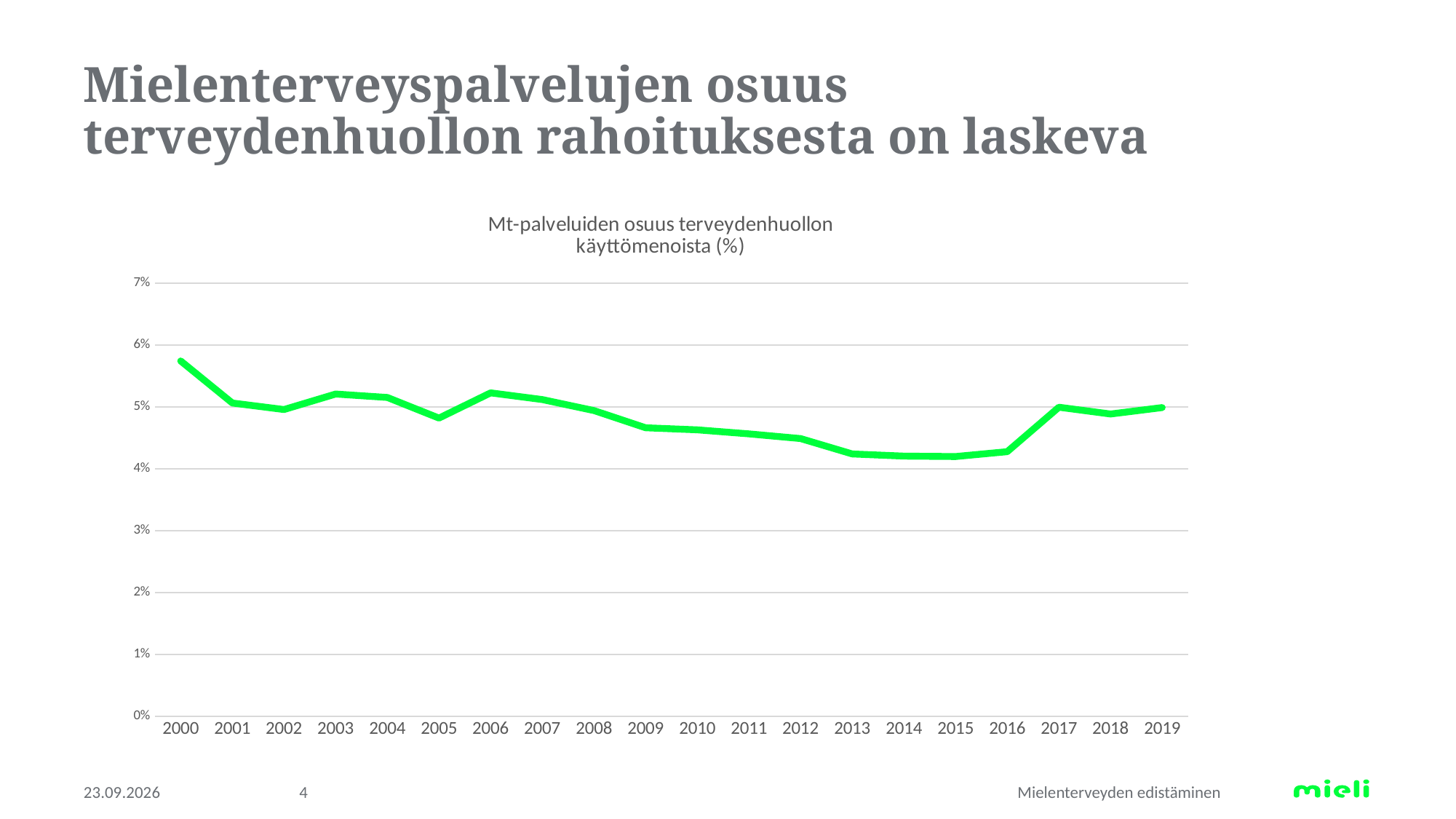
Is the value for 2014 greater or less than 4%? greater Is the value for 2009 greater or less than 5%? less What kind of chart is shown on the slide? line chart Is the value for 2003 greater or less than 5%? greater Does the value generally rise or fall from 2000 to 2015? fall Which year has the larger value, 2006 or 2012? 2006 Which year has the larger value, 2000 or 2013? 2000 Which year has the highest value in the chart? 2000 What is the title of the chart? Mt-palveluiden osuus terveydenhuollon käyttömenoista (%) How many years are plotted on the x axis of the chart? 20